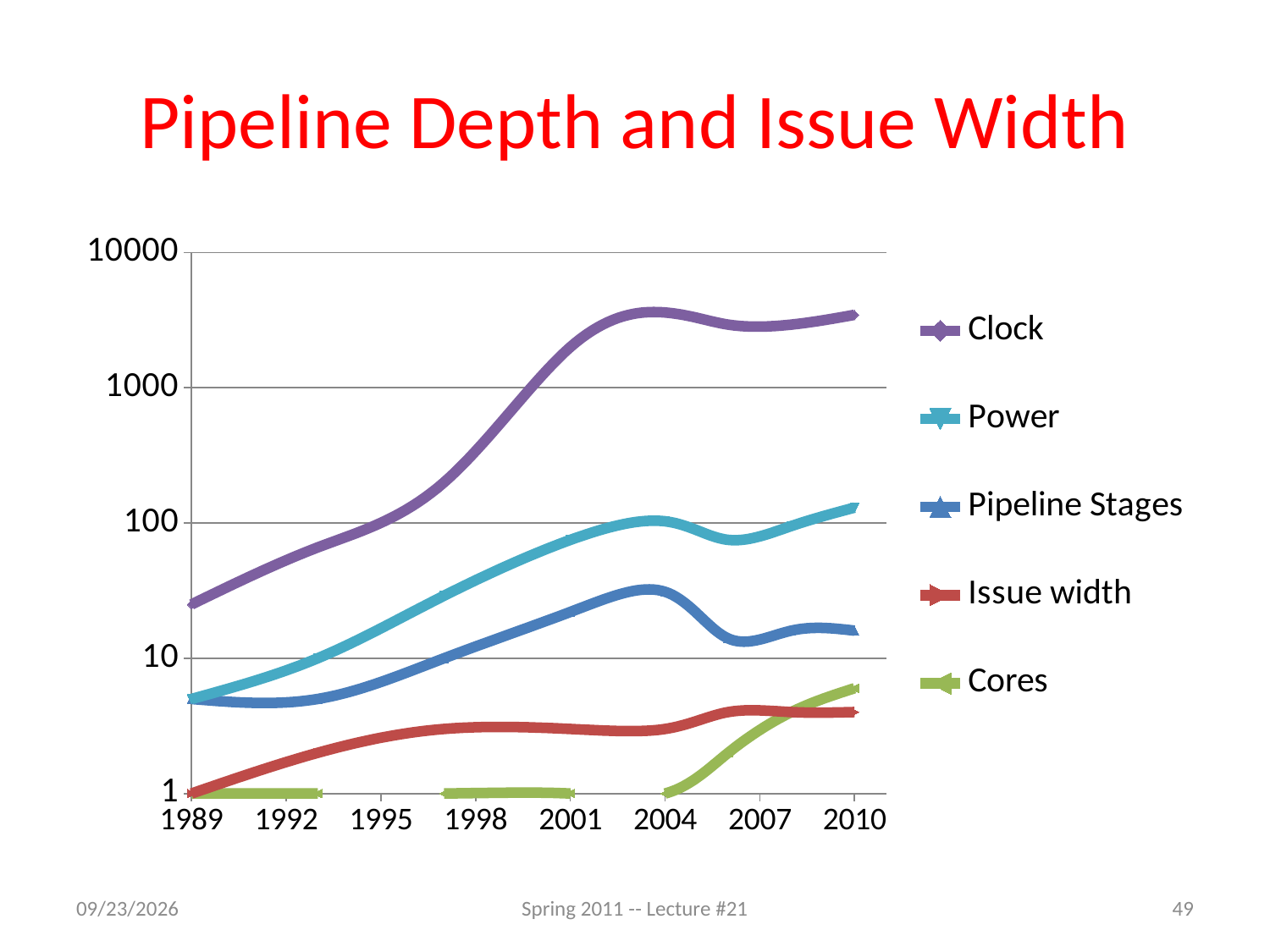
What is the value of Cores in 1989? 1 How many series does the legend list? 5 In 2004, which is larger: Pipeline Stages or Issue width? Pipeline Stages Is the value for Pipeline Stages in 2004 greater or less than 10? greater Is the value for Cores in 2010 greater or less than 10? less Is the value for Clock in 1989 greater or less than 10? greater Which series has the highest value in 2010? Clock Does the Clock series rise or fall from 1989 to 2004? rise What kind of chart is shown on the slide? line chart What is the title of the slide containing the chart? Pipeline Depth and Issue Width Which series is shown in green in the legend? Cores